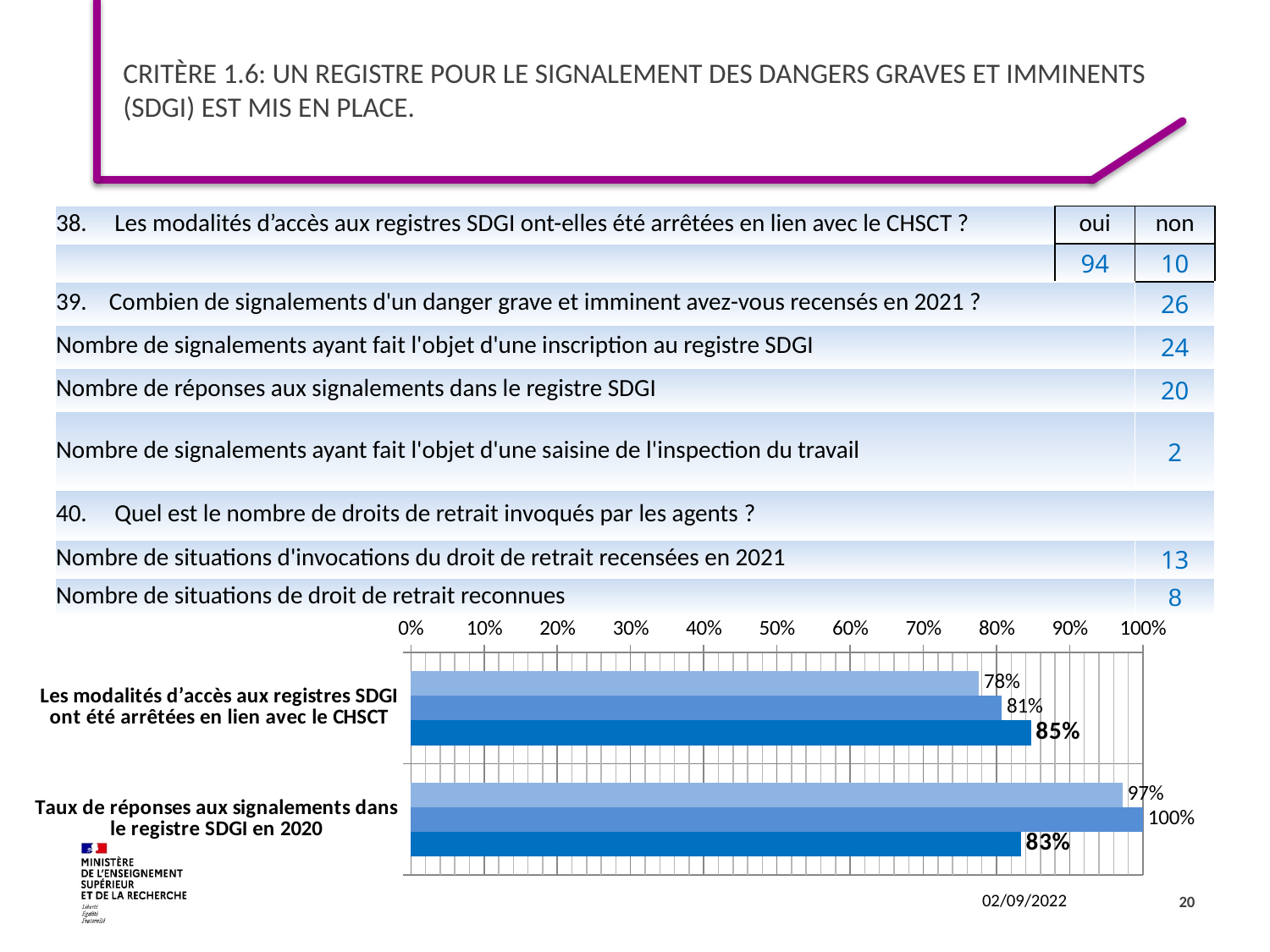
What is the value of the bottom (dark blue) bar for 'Taux de réponses aux signalements dans le registre SDGI en 2020'? 83% Which bar has the highest value on the chart? the middle bar for 'Taux de réponses aux signalements dans le registre SDGI en 2020' (100%) How many bars are plotted for each category on the chart? 3 Is the value of the top bar for 'Taux de réponses aux signalements dans le registre SDGI en 2020' greater or less than 90%? greater What is the value of the middle bar for 'Taux de réponses aux signalements dans le registre SDGI en 2020'? 100% What is the value of the top (light blue) bar for 'Les modalités d'accès aux registres SDGI ont été arrêtées en lien avec le CHSCT'? 78% What is the difference between the bottom bar (85%) and the top bar (78%) for 'Les modalités d'accès aux registres SDGI ont été arrêtées en lien avec le CHSCT'? 7 percentage points How many categories are shown on the chart's vertical axis? 2 Which is larger: the dark blue bar for 'Les modalités d'accès aux registres SDGI' or the dark blue bar for 'Taux de réponses aux signalements dans le registre SDGI en 2020'? Les modalités d'accès aux registres SDGI (85%) What kind of chart is shown at the bottom of the slide? bar chart Which bar has the lowest value on the chart? the top bar for 'Les modalités d'accès aux registres SDGI ont été arrêtées en lien avec le CHSCT' (78%) What is the value of the bottom (dark blue) bar for 'Les modalités d'accès aux registres SDGI ont été arrêtées en lien avec le CHSCT'? 85%